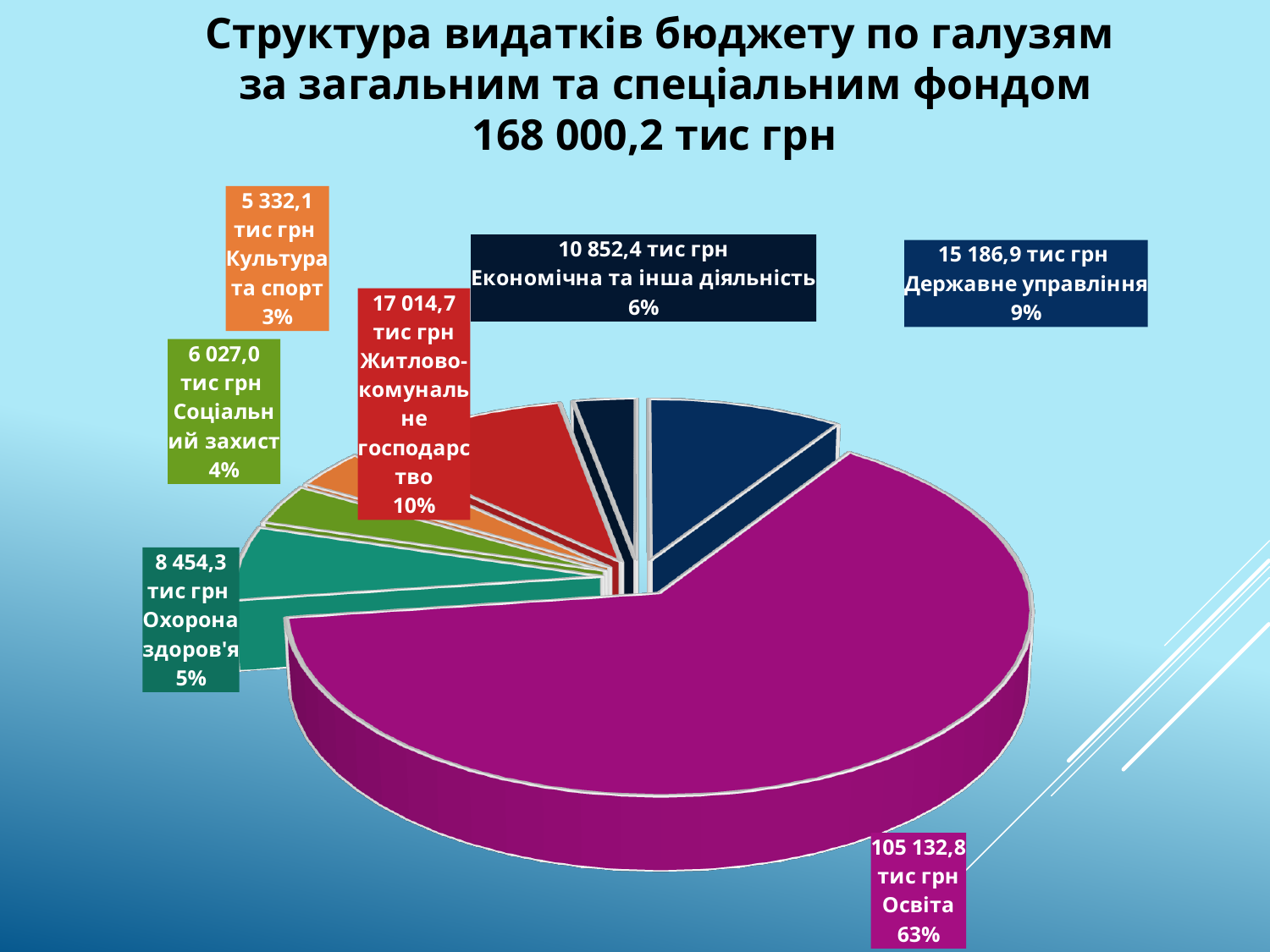
What share of the pie does Освіта represent? 63% How many slices does the pie chart have? 7 What is the value for Державне управління? 15 186,9 тис грн What share of the pie does Житлово-комунальне господарство represent? 10% What total amount is stated in the chart title? 168 000,2 тис грн What is the value for Охорона здоров'я? 8 454,3 тис грн Which category has the largest slice? Освіта What kind of chart is shown on the slide? pie chart Which category has the smallest slice? Культура та спорт Which is larger, Державне управління or Економічна та інша діяльність? Державне управління What is the difference between the values for Житлово-комунальне господарство and Державне управління? 1 827,8 тис грн What is the value for Освіта? 105 132,8 тис грн